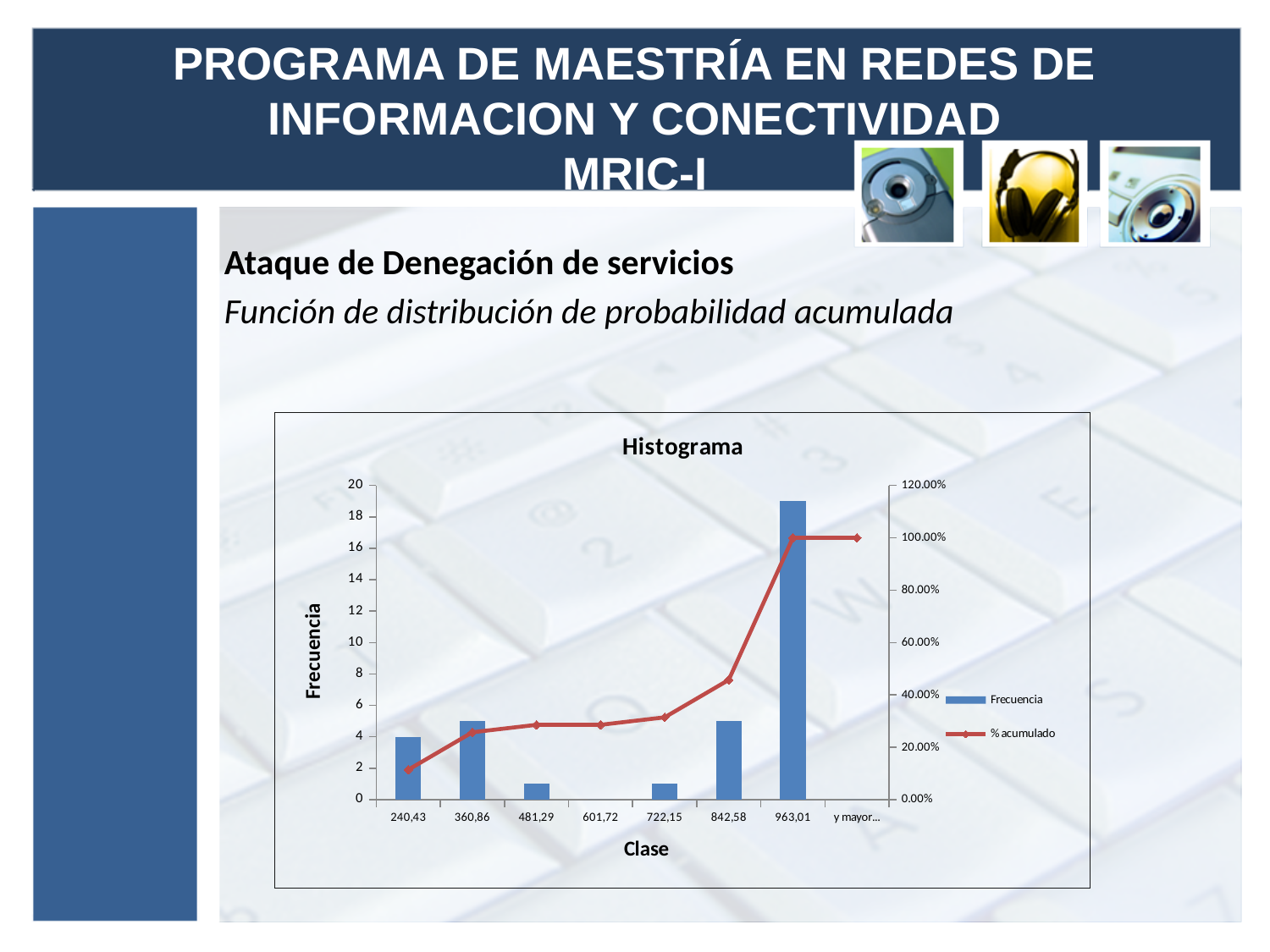
How many series does the legend list? 2 Is the Frecuencia for class 360,86 greater or less than 4? greater How many classes are shown on the x axis? 8 What is the title of the chart? Histograma Which class has the highest Frecuencia? 963,01 What is the Frecuencia for class 240,43? 4 Does the % acumulado line rise or fall from left to right along the x axis? rise What kind of chart is shown on the slide? bar chart with a line Which has a higher Frecuencia, class 360,86 or class 481,29? 360,86 Is the Frecuencia for class 842,58 greater or less than 6? less Is the Frecuencia for class 963,01 greater or less than 18? greater What is the % acumulado value at the class 'y mayor...'? 100.00%